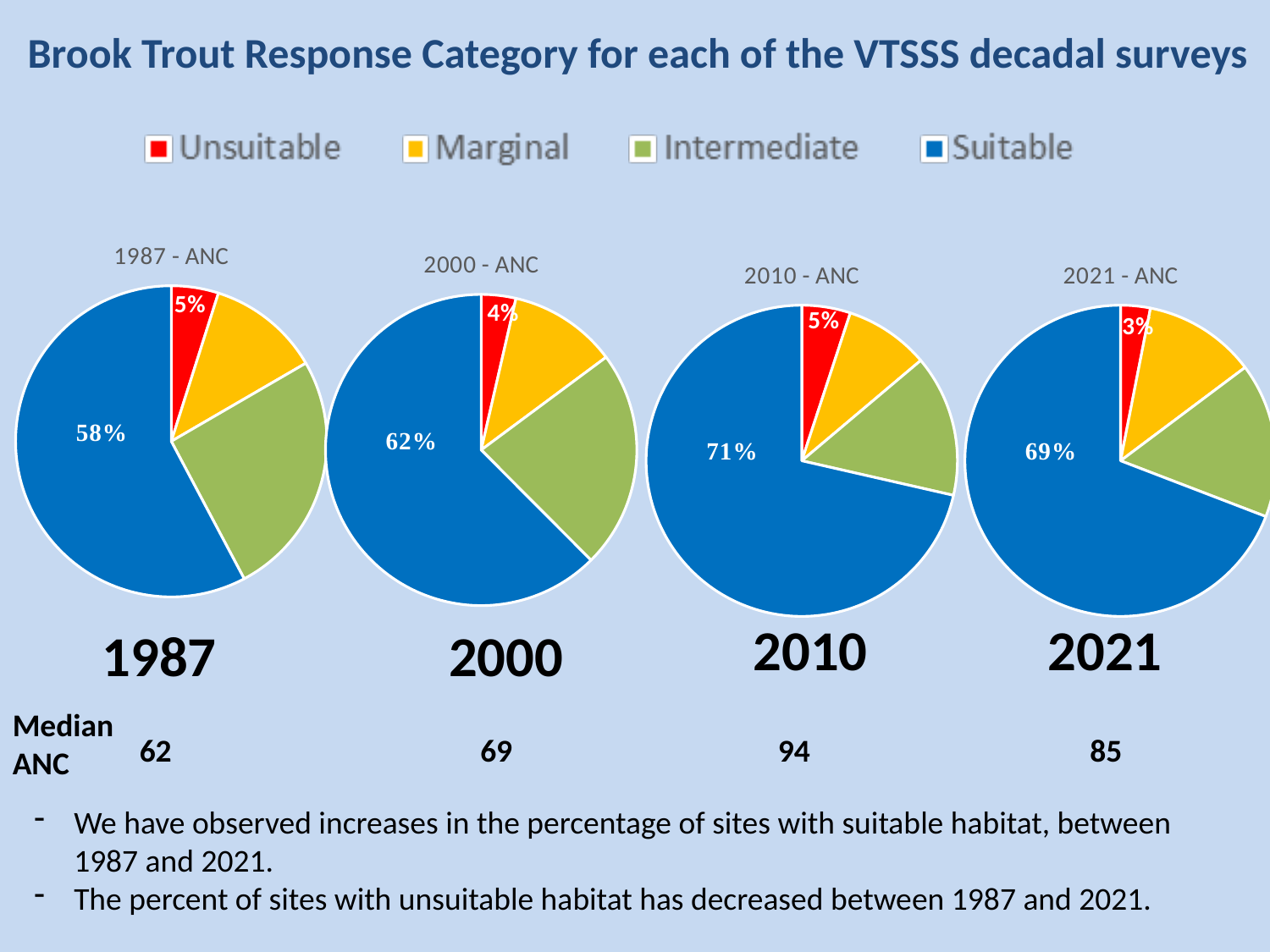
How many pie charts are shown on the slide? 4 How many percentage points higher is the Suitable share in the 2010 - ANC pie chart than in the 1987 - ANC pie chart? 13 percentage points In the 2010 - ANC pie chart, what percentage of sites is Suitable? 71% Across the four pie charts, which survey year has the highest Suitable percentage? 2010 Is the Suitable percentage larger in the 2000 - ANC pie chart or the 2021 - ANC pie chart? 2021 - ANC Across the four pie charts, which survey year has the lowest Unsuitable percentage? 2021 In the 2021 - ANC pie chart, what percentage is shown for the Unsuitable slice? 3% In the 2000 - ANC pie chart, what percentage is shown for the Unsuitable slice? 4% In the 1987 - ANC pie chart, which category has the largest slice? Suitable What type of chart is used to show the Brook Trout response categories? Pie chart How many categories does the legend list for the pie charts? 4 In the 1987 - ANC pie chart, what percentage of sites is labelled as Suitable? 58%